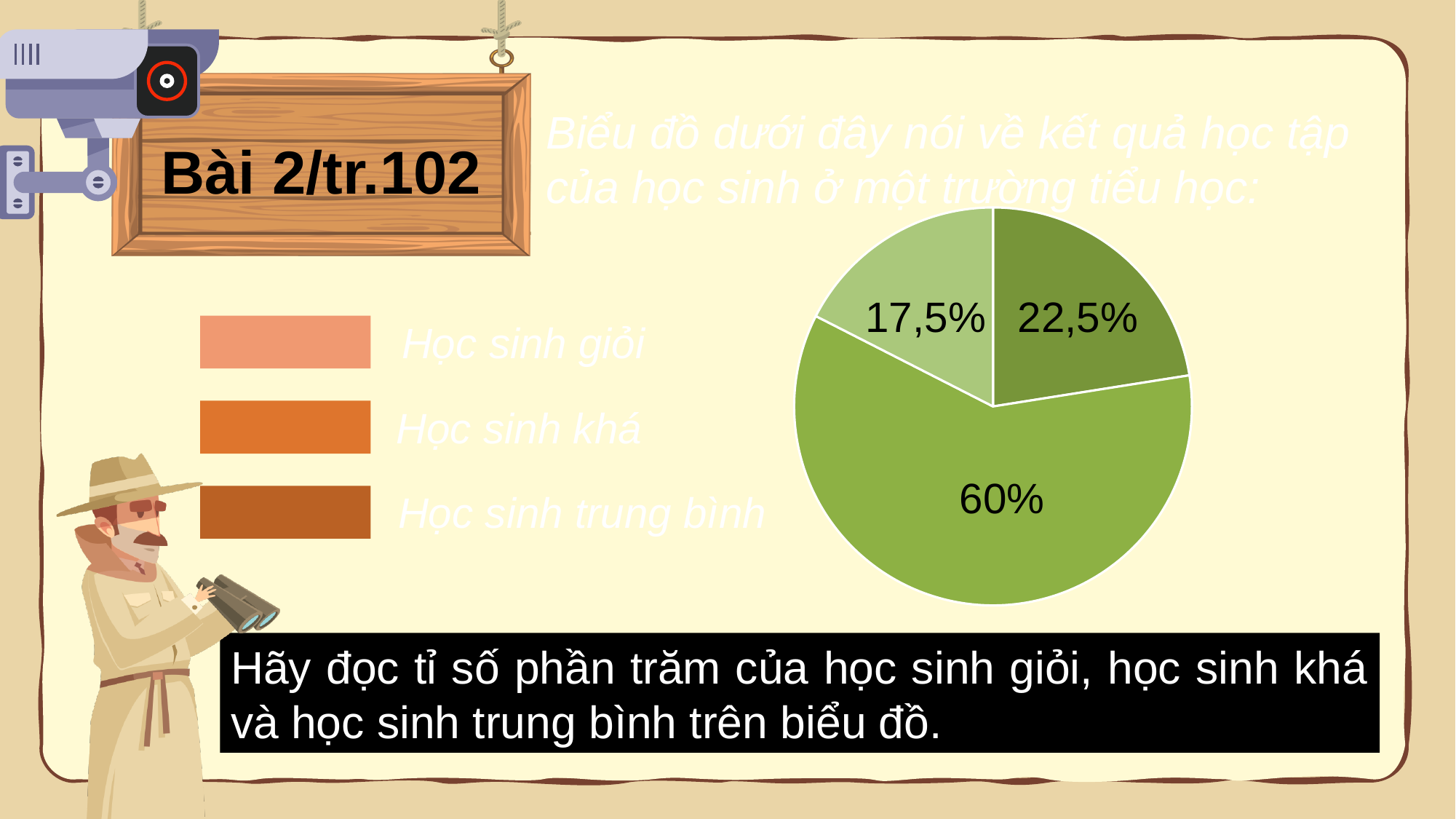
What kind of chart is shown on the slide? Pie chart What is the difference between the 22,5% slice and the 17,5% slice? 5% What is the value of the dark green slice at the top right of the pie chart? 22,5% What is the value of the smallest slice of the pie chart? 17,5% How many slices does the pie chart have? 3 What share of the pie do the two smaller slices together make up? 40% Which is larger, the dark green slice at the top right or the light green slice at the top left? The dark green slice (22,5%) What do the three slices of the pie chart add up to? 100% What is the value of the largest slice of the pie chart? 60% What is the value of the light green slice at the top left of the pie chart? 17,5% What is the difference between the largest slice (60%) and the 22,5% slice? 37,5% How many entries does the legend on the left of the slide list? 3